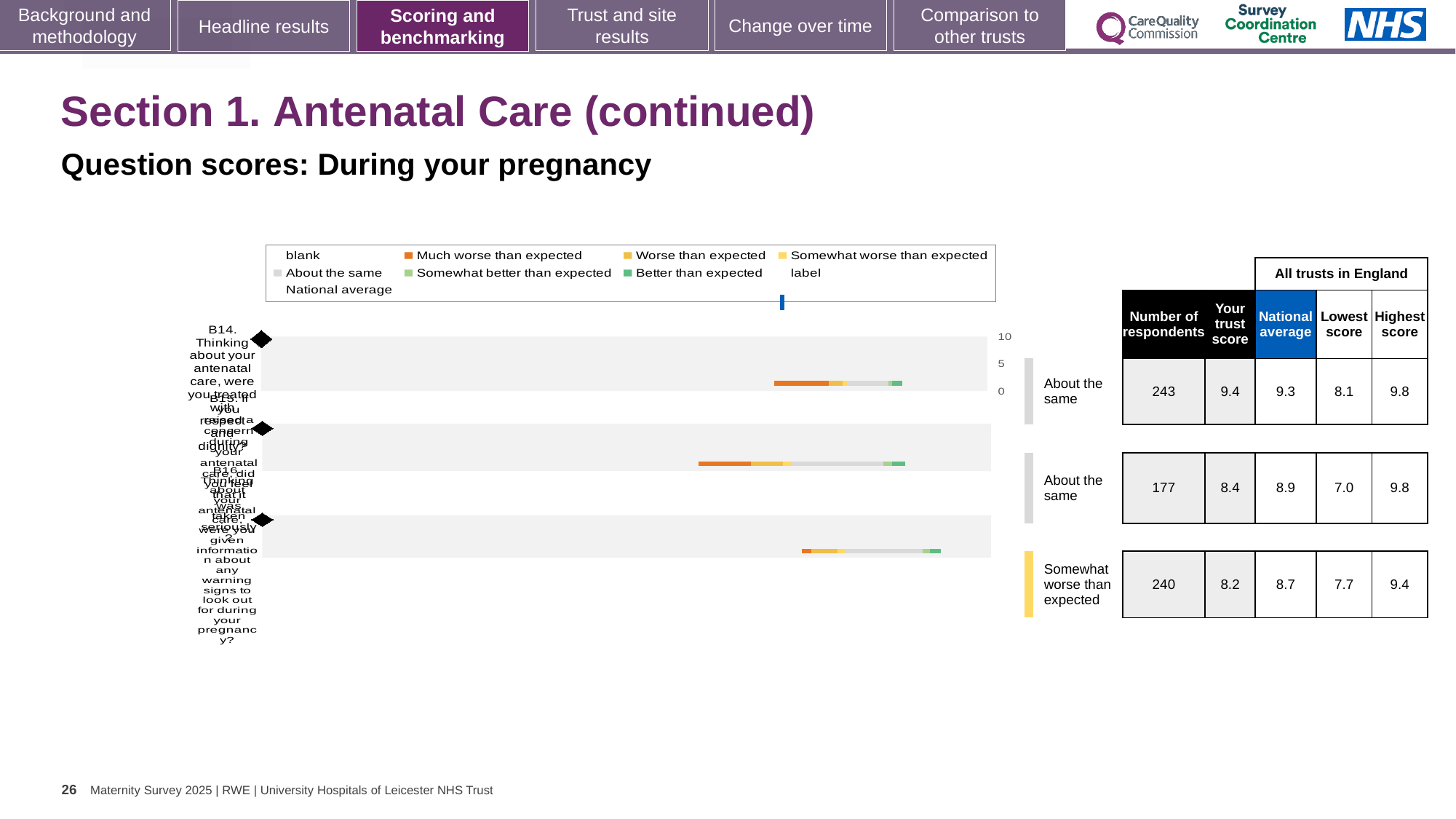
In the table next to the chart, what is the national average in the second row? 8.9 In the table next to the chart, what is the number of respondents in the first row? 243 How many entries does the chart legend list? 9 In the table next to the chart, what is 'Your trust score' in the first row? 9.4 In the table next to the chart, what is the difference between the highest score and lowest score in the second row? 2.8 In the table next to the chart, what is the lowest score in the third row? 7.7 In the table next to the chart, is 'Your trust score' in the third row larger or smaller than the national average in that row? smaller In the table next to the chart, which row has the highest 'Your trust score'? the first row (9.4) What colour represents 'Much worse than expected' in the chart legend? orange What kind of chart is shown on the slide? bar chart How many question bars are plotted in the chart? 3 What colour represents 'Better than expected' in the chart legend? green